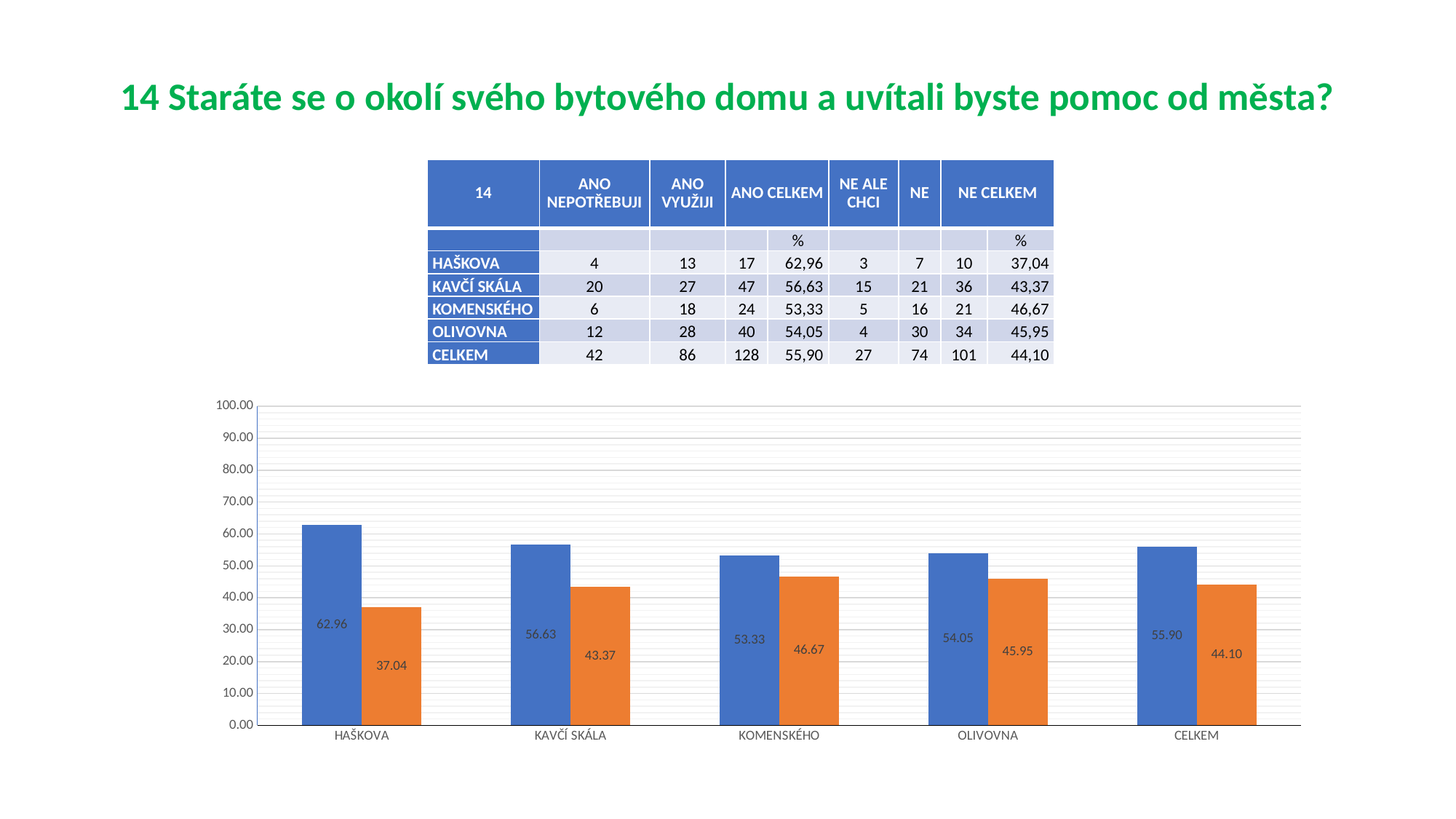
Which is larger for KOMENSKÉHO, the blue bar or the orange bar? the blue bar What kind of chart is shown on the slide? bar chart What is the value of the blue bar for HAŠKOVA? 62.96 Which category has the highest blue bar? HAŠKOVA What is the value of the blue bar for OLIVOVNA? 54.05 Is the value of the blue bar for HAŠKOVA greater or less than 60.00? greater What is the highest value shown on the y axis of the chart? 100.00 How many categories are shown on the x axis of the chart? 5 What is the value of the orange bar for CELKEM? 44.10 What is the difference between the blue and orange bars for KAVČÍ SKÁLA? 13.26 What is the value of the orange bar for KOMENSKÉHO? 46.67 Which category has the lowest orange bar? HAŠKOVA